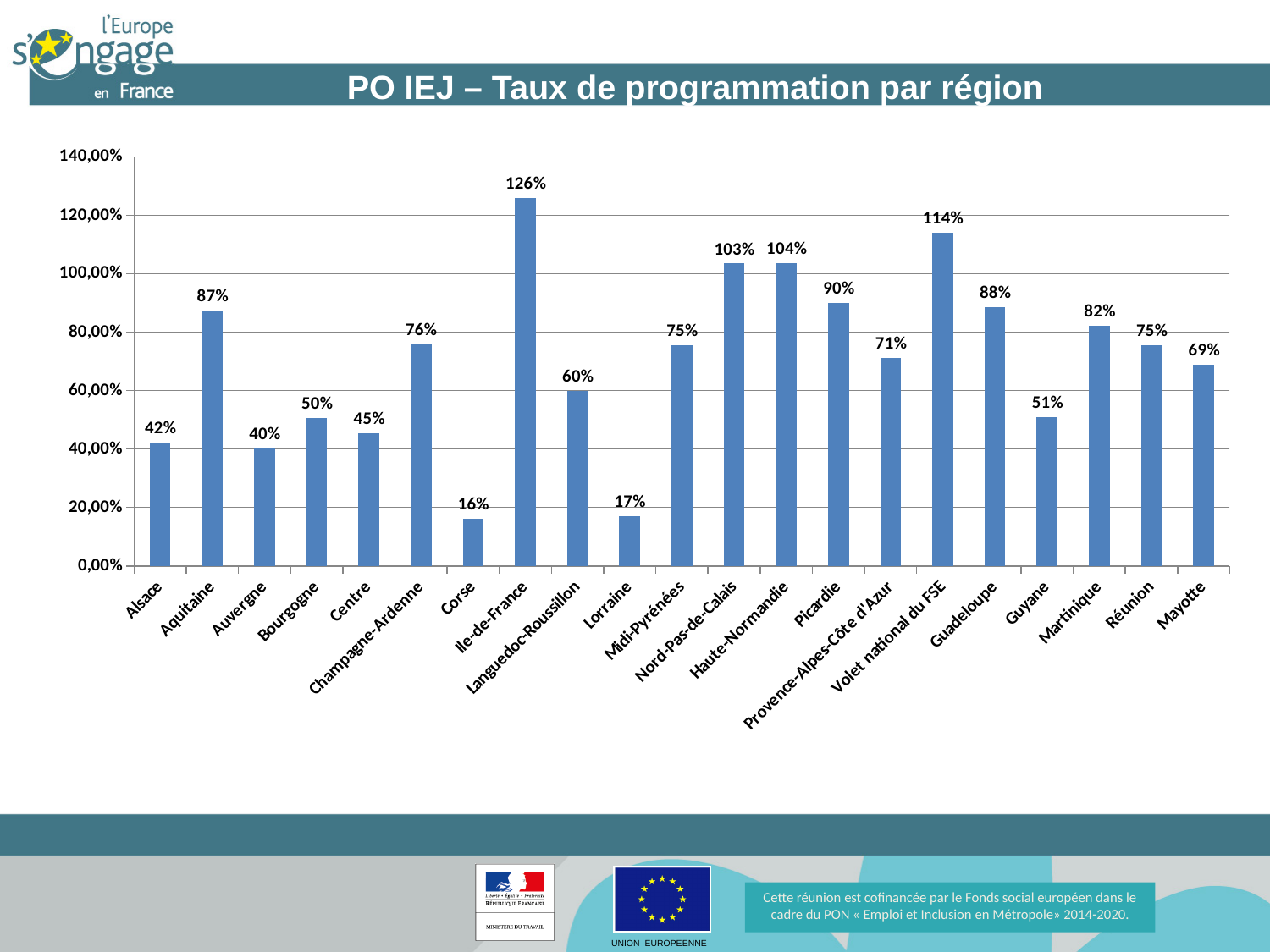
What is the value for Volet national du FSE? 114% What is the value for Ile-de-France? 126% What kind of chart is shown on the slide? Bar chart Which region has the highest value? Ile-de-France What is the difference between the values for Aquitaine and Alsace? 45 percentage points Which region has the lowest value? Corse What is the value for Corse? 16% Which is larger, the value for Martinique or the value for Mayotte? Martinique Is the value for Volet national du FSE greater or less than 100,00%? greater What is the difference between the values for Ile-de-France and Corse? 110 percentage points What is the value for Guadeloupe? 88% How many regions are shown on the x axis? 21